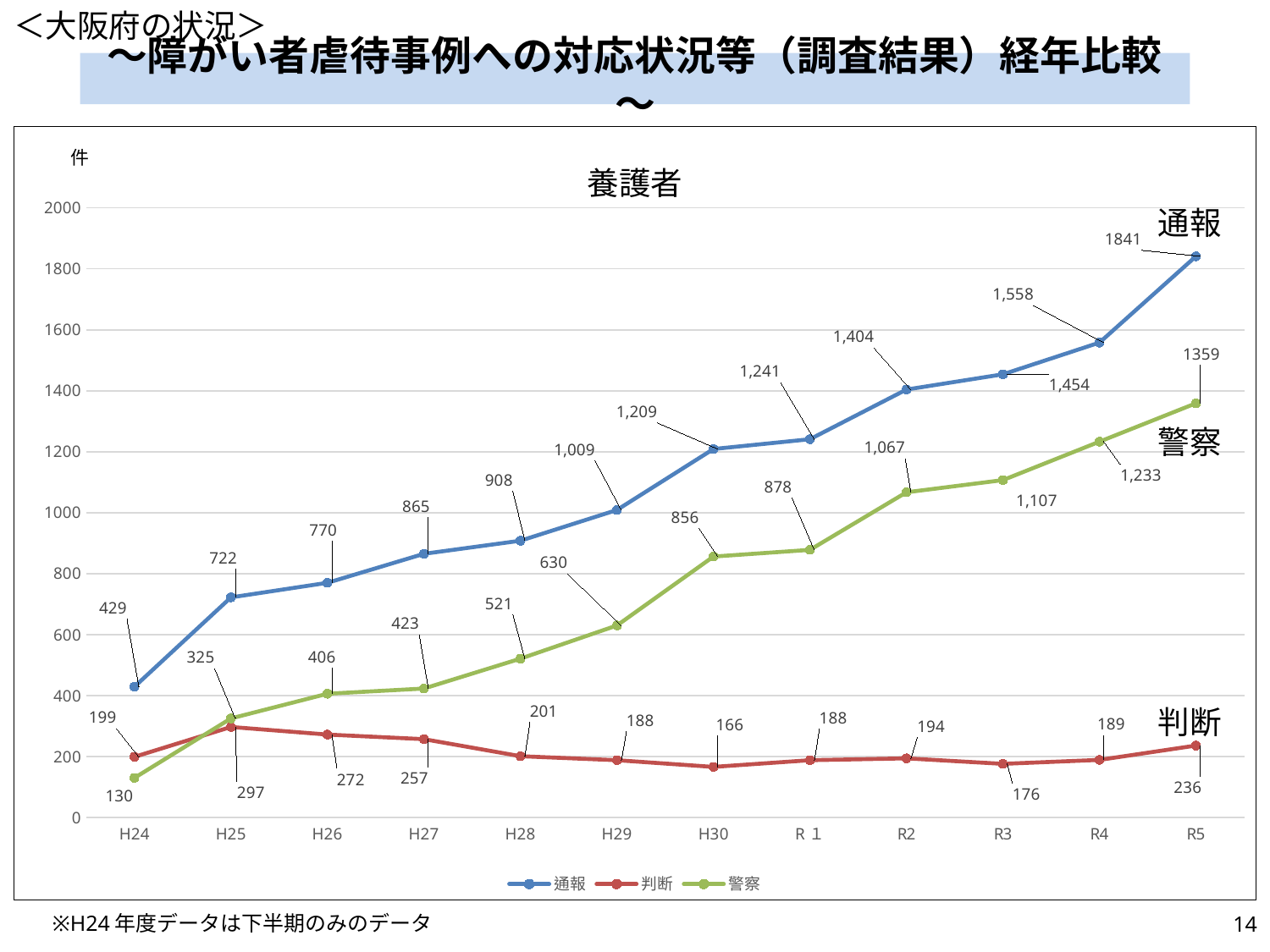
What is the value of 通報 in R5? 1841 Which is larger in H24, 判断 or 警察? 判断 In which year is 警察 at its highest? R5 What type of chart is shown on the slide? line chart What is the value of 警察 in H24? 130 What is the value of 判断 in H30? 166 What is the difference between 通報 and 警察 in R5? 482 How many series does the legend list? 3 What is the value of 通報 in H29? 1,009 How many years are shown on the x axis? 12 In which year is 判断 at its lowest? H30 Does the 通報 line rise or fall from H24 to R5? rise